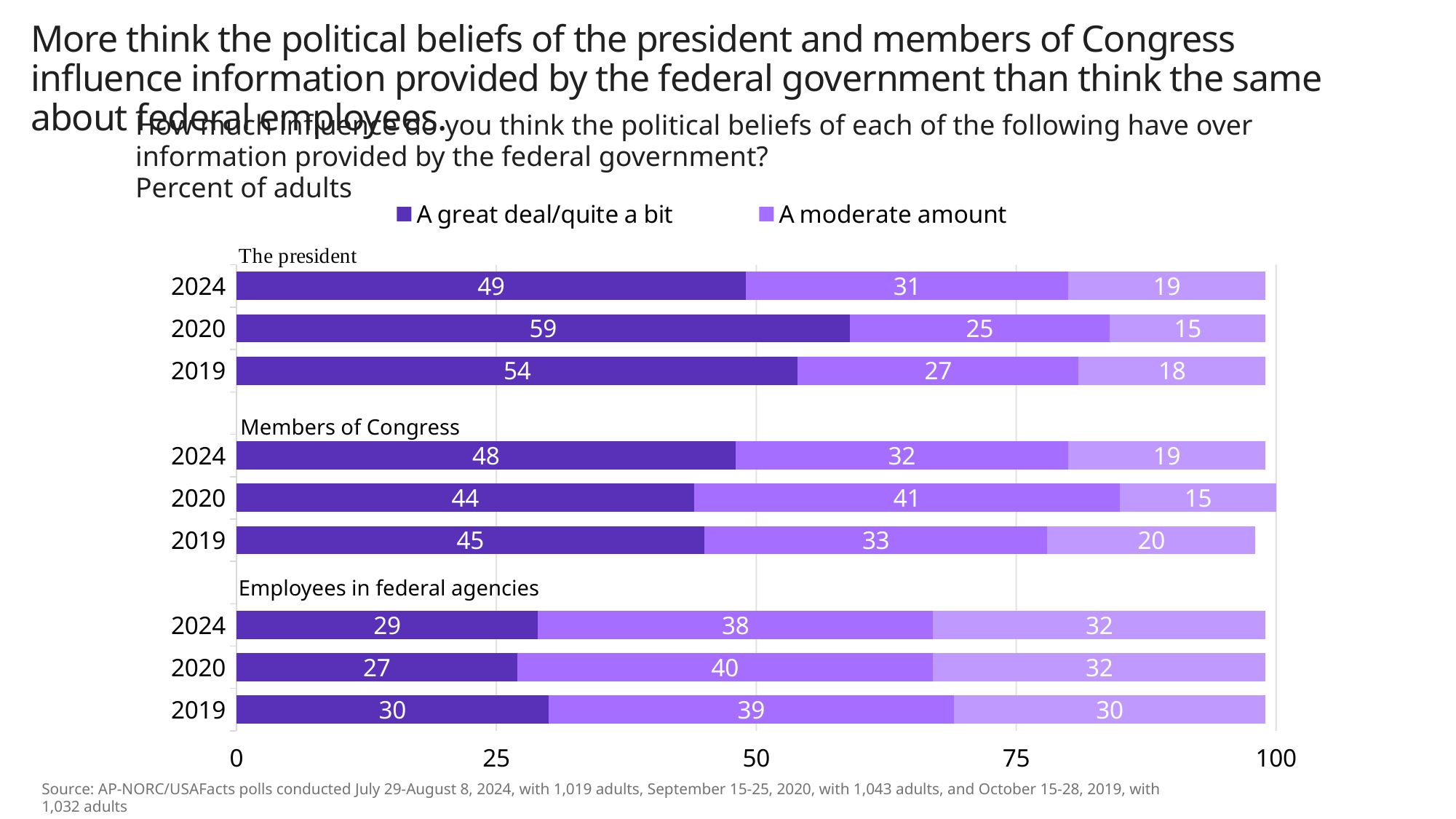
What percent of adults said the president's political beliefs have a great deal/quite a bit of influence in 2024? 49 What percent of adults said employees in federal agencies' political beliefs have a great deal/quite a bit of influence in 2019? 30 Which group had the lowest 'A great deal/quite a bit' value in 2020? Employees in federal agencies What kind of chart is shown on the slide? Stacked bar chart Is the 'A great deal/quite a bit' value for members of Congress in 2024 greater or less than 25? greater How many bars are plotted in the chart? 9 What is the total of the three labeled segments for the president's 2024 bar? 99 What is the difference between the 'A great deal/quite a bit' values for the president in 2020 and 2024? 10 How many series does the legend list? 2 What percent of adults said members of Congress's political beliefs have a moderate amount of influence in 2020? 41 Which is larger: the 'A moderate amount' value for employees in federal agencies in 2020 or for the president in 2020? Employees in federal agencies in 2020 In which year was the 'A great deal/quite a bit' value for the president highest? 2020